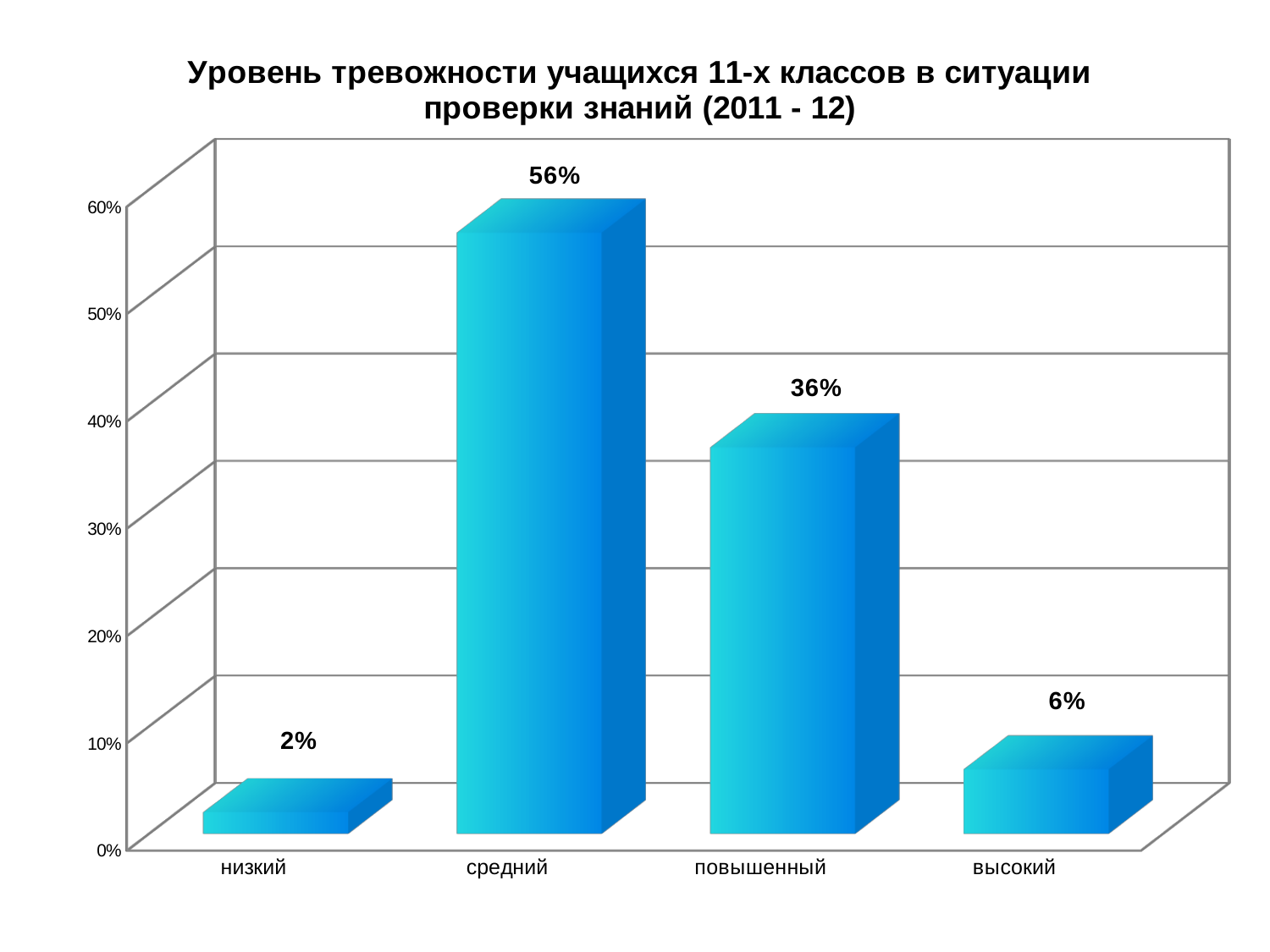
How many categories are shown on the x axis? 4 Which is larger, the value for высокий or the value for низкий? высокий What is the value for средний? 56% Which category has the highest value? средний What is the value for низкий? 2% What kind of chart is this? bar chart What is the value for высокий? 6% What is the difference between the values for средний and повышенный? 20% Is the value for повышенный greater or less than 30%? greater What is the title of the chart? Уровень тревожности учащихся 11-х классов в ситуации проверки знаний (2011 - 12) What is the value for повышенный? 36% Which category has the lowest value? низкий